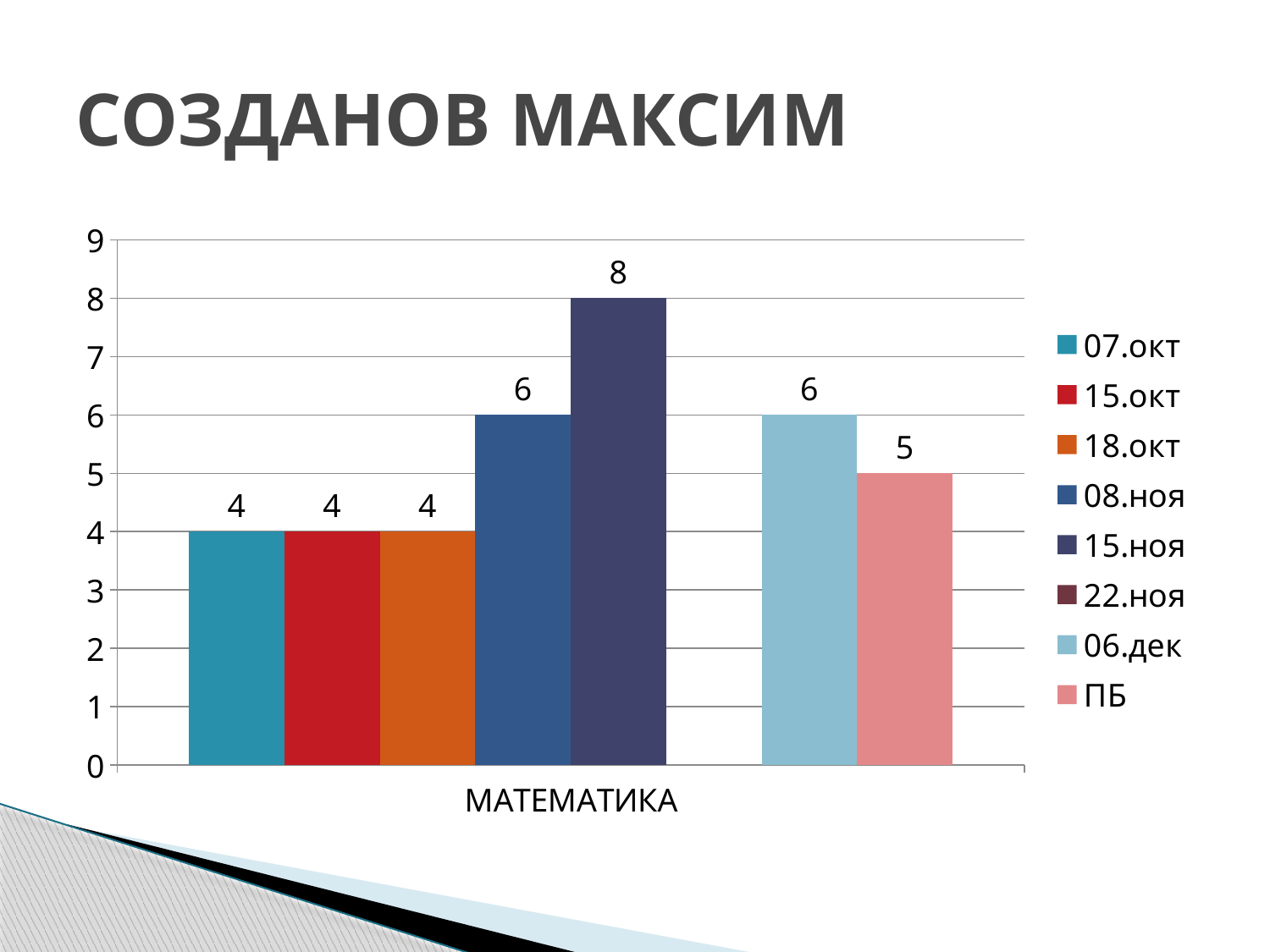
What is the difference between the values for ПБ and 18.окт? 1 What is the value for 08.ноя in МАТЕМАТИКА? 6 What category label is shown on the x axis? МАТЕМАТИКА Which is larger, the value for 06.дек or the value for ПБ? 06.дек How many series does the legend list? 8 What is the value for 15.ноя in МАТЕМАТИКА? 8 What is the difference between the values for 15.ноя and 08.ноя? 2 What kind of chart is shown on the slide? bar chart Which legend series has no visible bar in the chart? 22.ноя What is the value for 07.окт in МАТЕМАТИКА? 4 What is the value for ПБ in МАТЕМАТИКА? 5 Which series has the highest value in МАТЕМАТИКА? 15.ноя